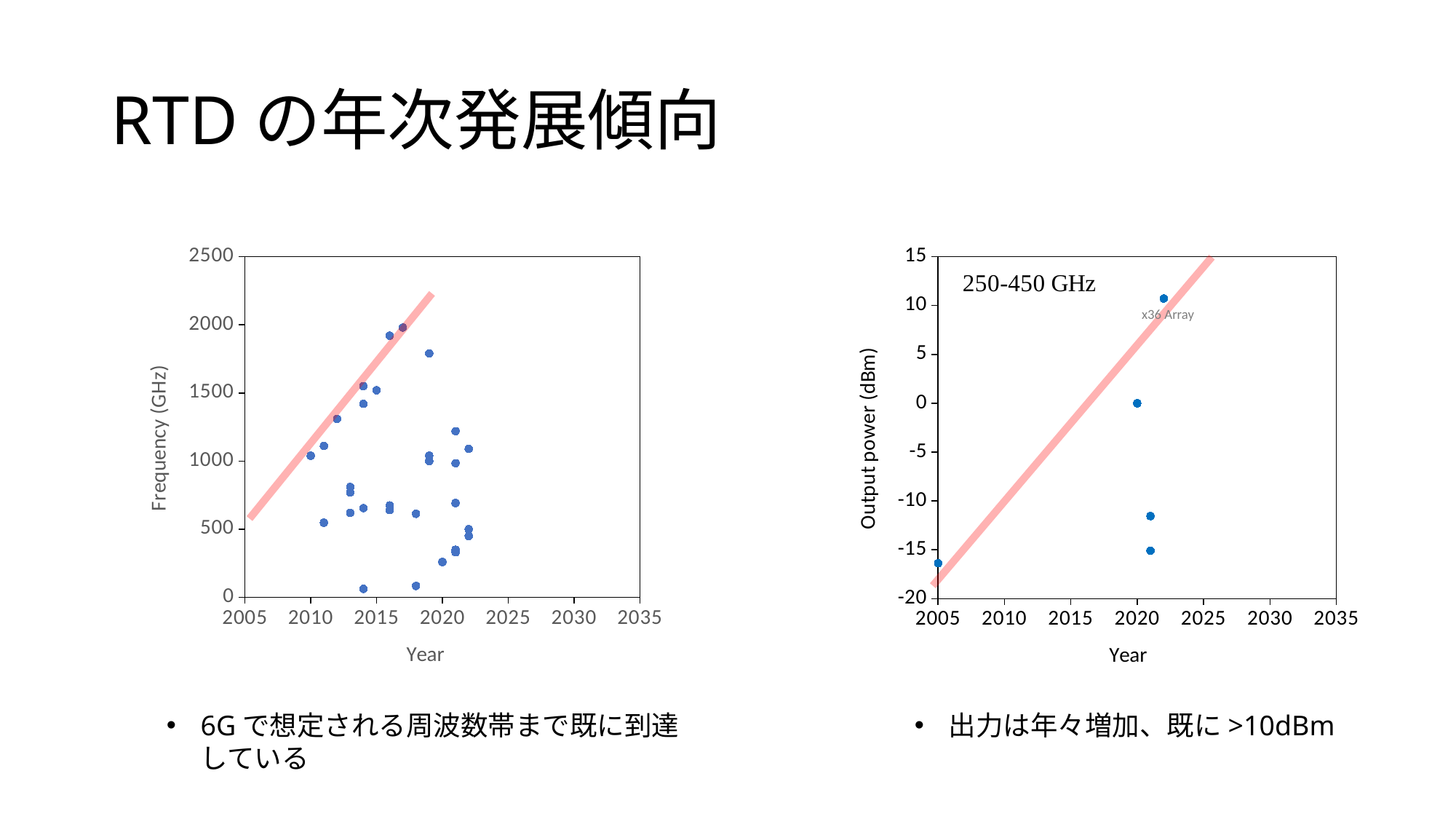
On the right chart, does the pink trend line rise or fall as the year increases? rise On the right chart, which year has the point with the highest output power, 2005 or 2022? 2022 On the right chart, is the output power of the point plotted at 2005 greater or less than -15? less On the left chart, is the lowest plotted frequency greater or less than 500 GHz? less On the left chart, does the pink trend line rise or fall as the year increases? rise What kind of chart is the right chart (Output power vs Year)? scatter chart On the right chart, is the output power of the point plotted at 2022 greater or less than 5? greater On the left chart, what is the label of the y axis? Frequency (GHz) On the right chart, what is the label of the y axis? Output power (dBm) What kind of chart is the left chart (Frequency vs Year)? scatter chart On the right chart, what is the maximum value shown on the y axis? 15